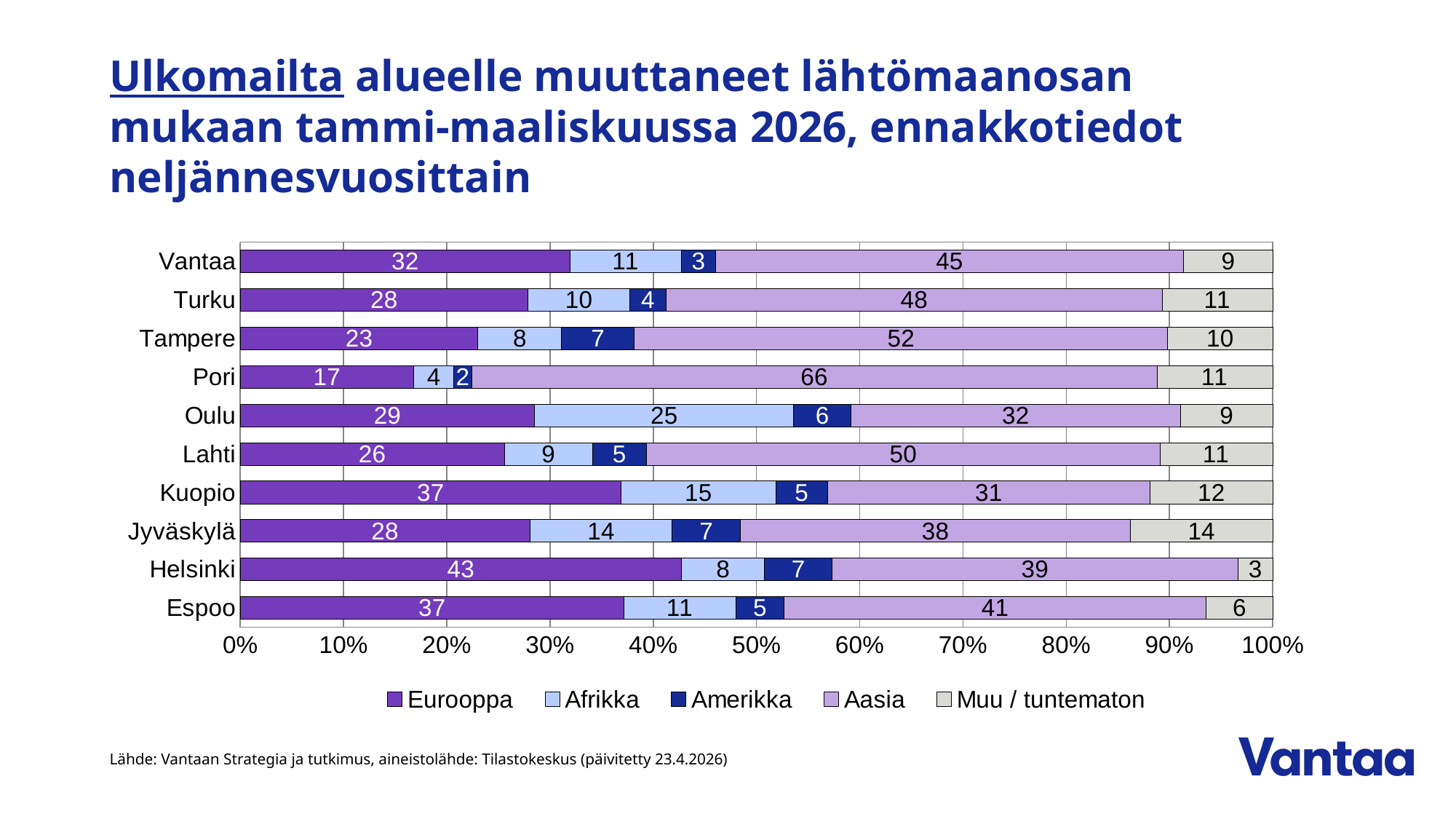
What is the value for Amerikka in the Tampere bar? 7 What is the last entry in the chart legend? Muu / tuntematon Which is larger, the Afrikka value for Oulu or for Kuopio? Oulu What is the value for Aasia in the Vantaa bar? 45 Which city has the highest value for Afrikka? Oulu Which city has the highest value for Aasia? Pori How many series does the legend list? 5 Which city has the lowest value for Muu / tuntematon? Helsinki What kind of chart is shown on the slide? Stacked bar chart What is the value for Eurooppa in the Helsinki bar? 43 How many cities are shown in the chart? 10 What is the difference between the Eurooppa values for Helsinki and Pori? 26